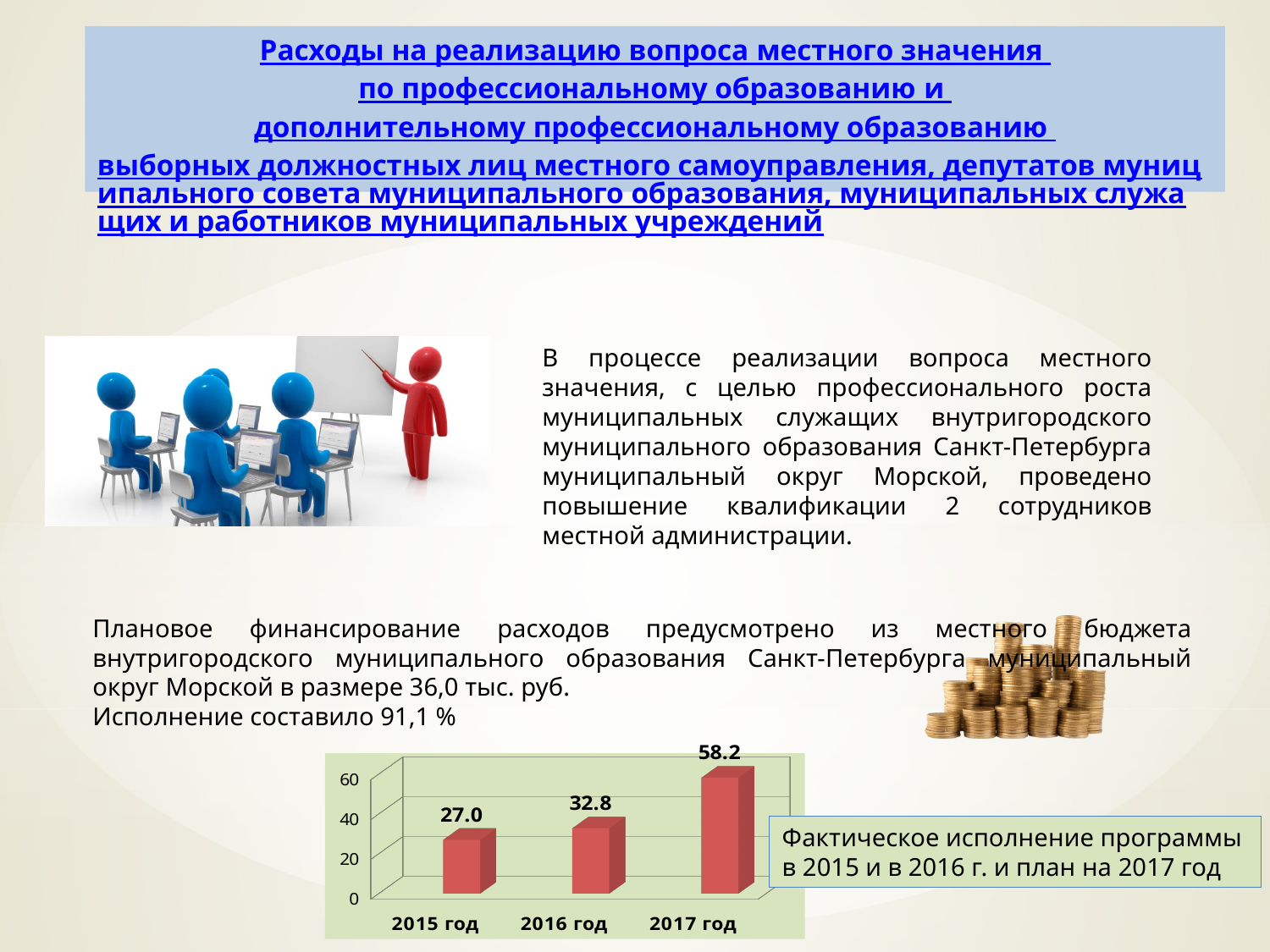
Do the values rise or fall from 2015 год to 2017 год? rise What is the value shown for 2015 год? 27.0 What is the difference between the values for 2016 год and 2015 год? 5.8 What is the value shown for 2017 год? 58.2 Which year has the lowest value in the chart? 2015 год What kind of chart is shown on the slide? bar chart Which year has the highest value in the chart? 2017 год How many categories (years) are shown in the chart? 3 Which is larger, the value for 2015 год or the value for 2016 год? 2016 год What is the value shown for 2016 год? 32.8 What is the difference between the values for 2017 год and 2016 год? 25.4 Is the value for 2017 год greater or less than 40? greater